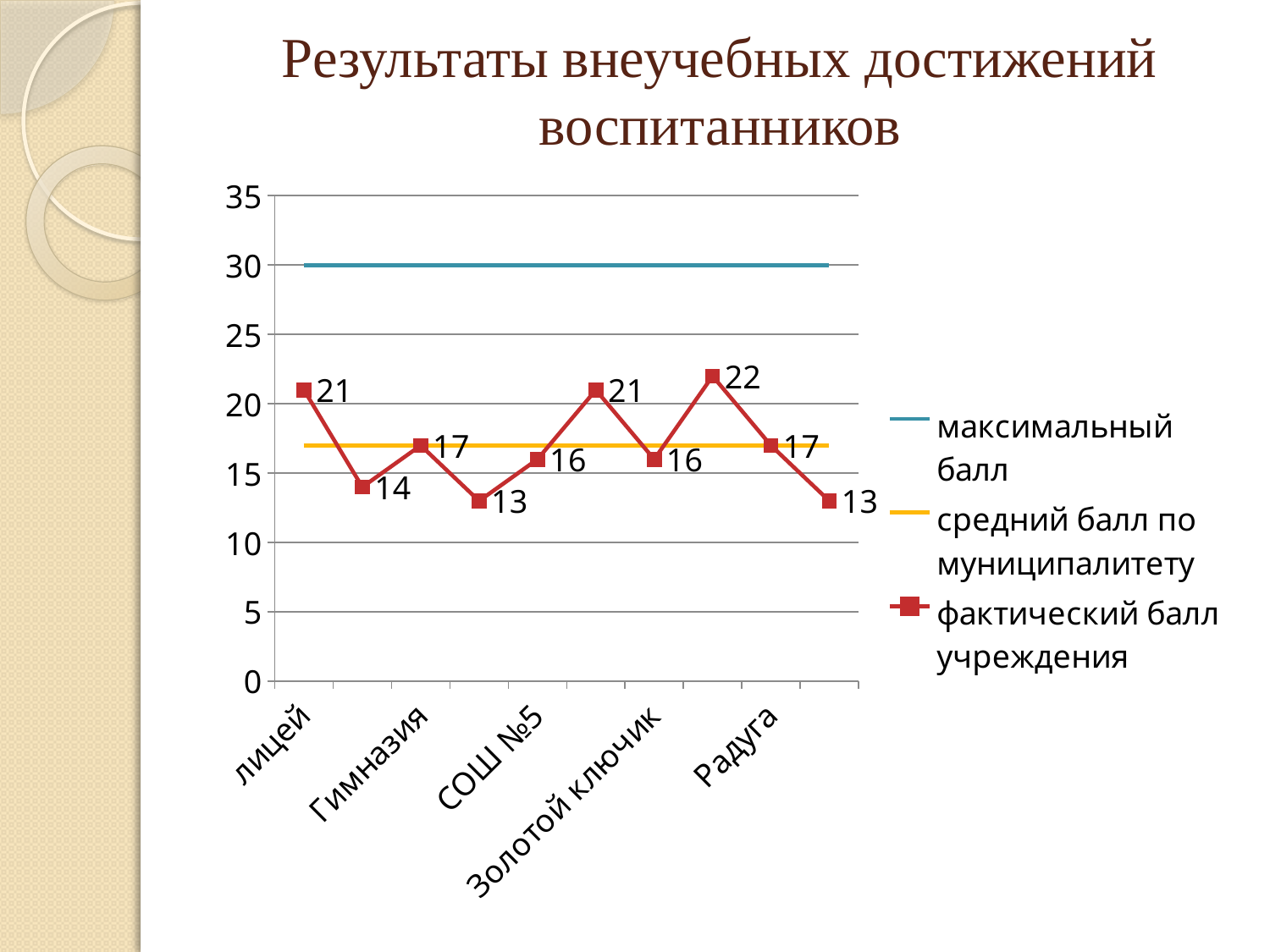
Which has a higher фактический балл учреждения value, лицей or СОШ №5? лицей What is the title of the chart on the slide? Результаты внеучебных достижений воспитанников What is the фактический балл учреждения value for Гимназия? 17 What is the difference between the фактический балл учреждения values for лицей and Гимназия? 4 What is the фактический балл учреждения value for лицей? 21 What kind of chart is shown on the slide? line chart What is the фактический балл учреждения value for Радуга? 17 What is the lowest value plotted on the фактический балл учреждения line? 13 Is the максимальный балл line greater or less than 25? greater How many series does the legend list? 3 What is the highest value plotted on the фактический балл учреждения line? 22 How many data points are plotted on the фактический балл учреждения line? 10